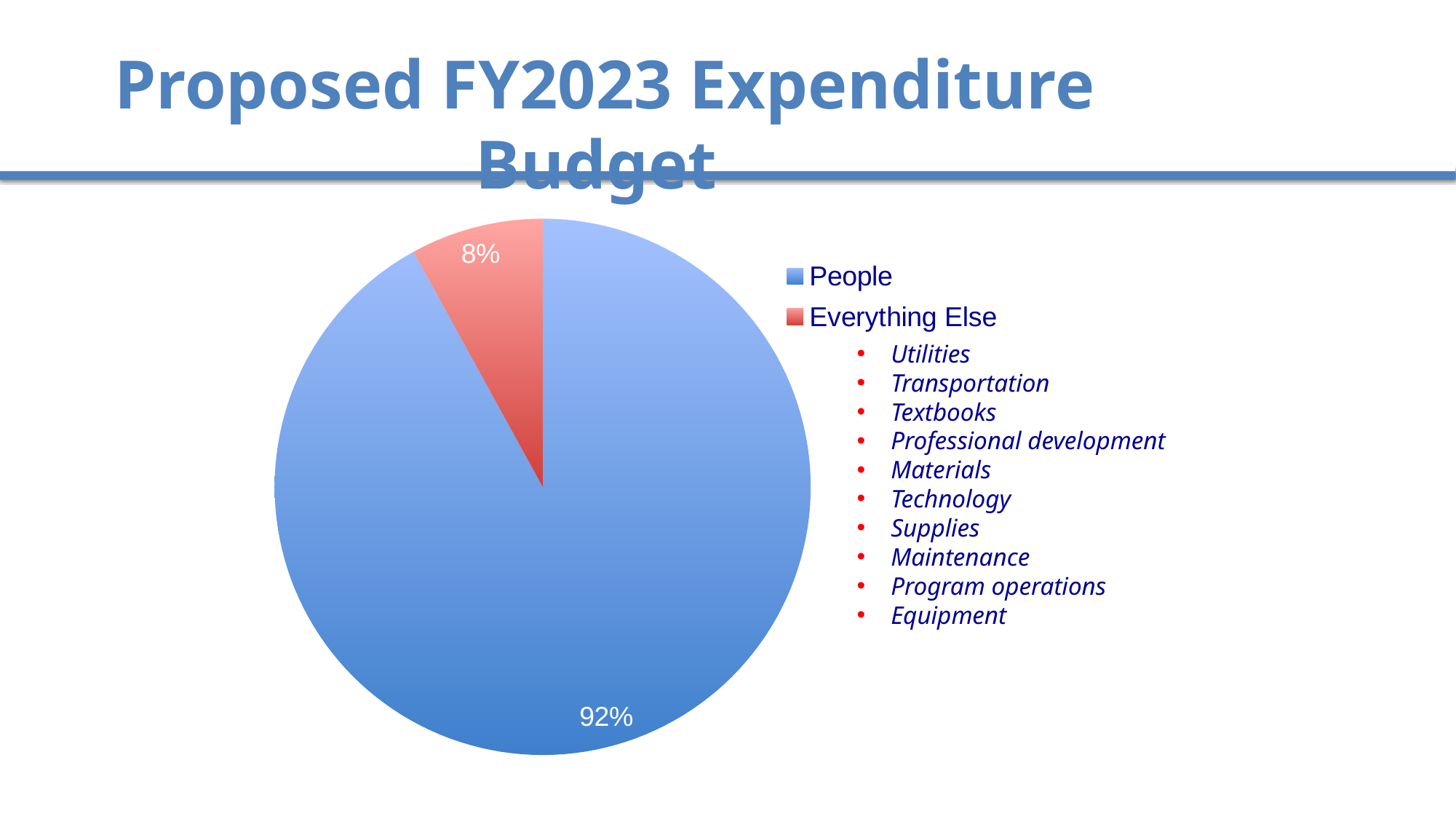
What colour is the People slice? Blue Which is larger, the People slice or the Everything Else slice? People Which slice of the pie is the largest? People Which slice of the pie is the smallest? Everything Else What is the difference in percentage points between the People slice and the Everything Else slice? 84 percentage points How many entries does the legend list? 2 What share of the pie does Everything Else account for? 8% What colour is the Everything Else slice? Red How many slices does the pie chart have? 2 What share of the pie does People account for? 92% What kind of chart is shown on the slide? Pie chart